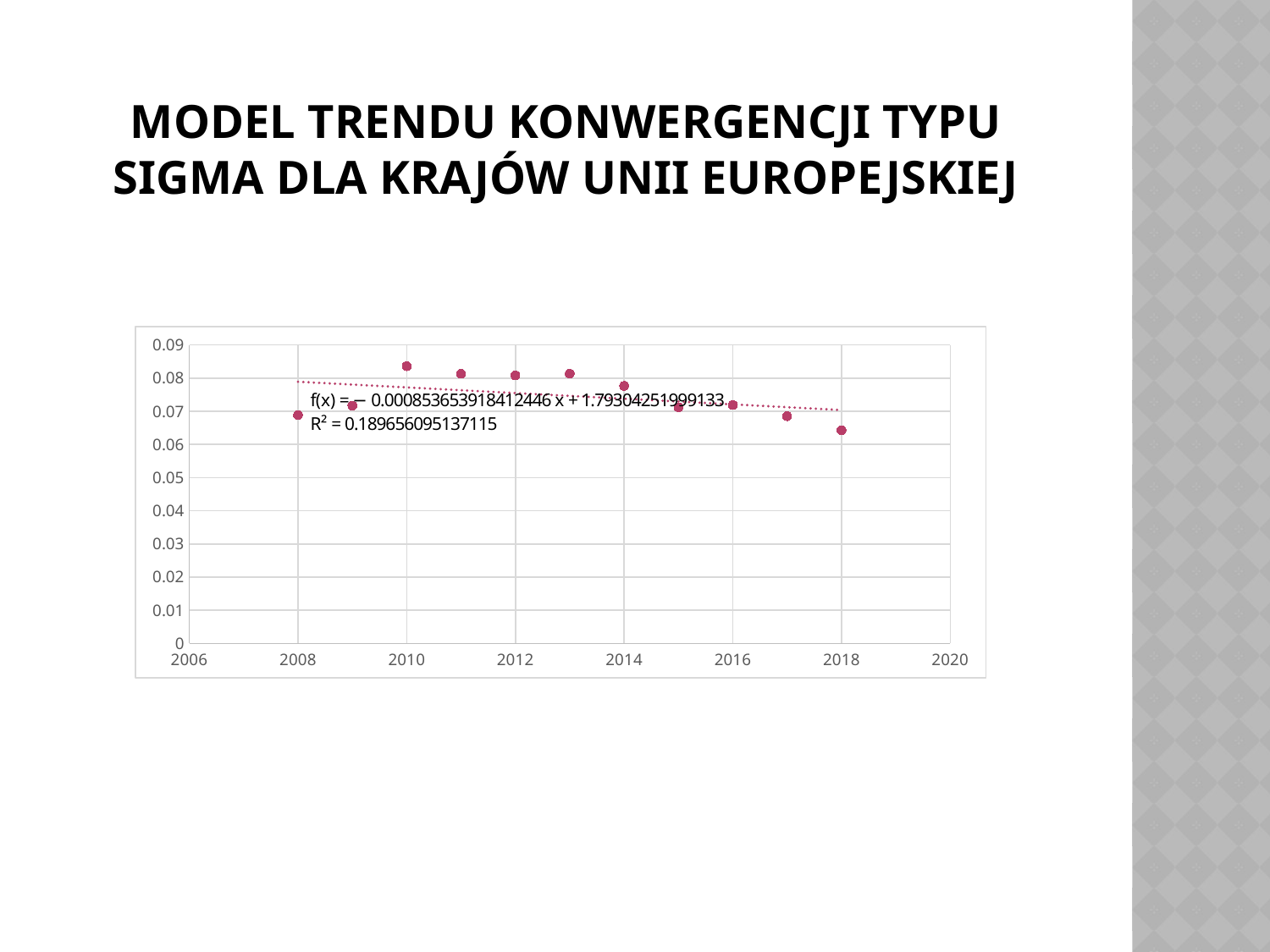
Which is larger, the value for 2010 or the value for 2018? 2010 Does the fitted trend line rise or fall from 2008 to 2018? fall Is the value for 2015 greater or less than 0.08? less What kind of chart is shown on the slide? scatter chart Which year has the highest plotted value? 2010 What is the first year label shown on the x axis? 2006 Is the value for 2010 greater or less than 0.08? greater Is the value for 2014 greater or less than 0.07? greater Which year has the lowest plotted value? 2018 What R² value is printed on the chart? 0.189656095137115 How many data points are plotted on the chart? 11